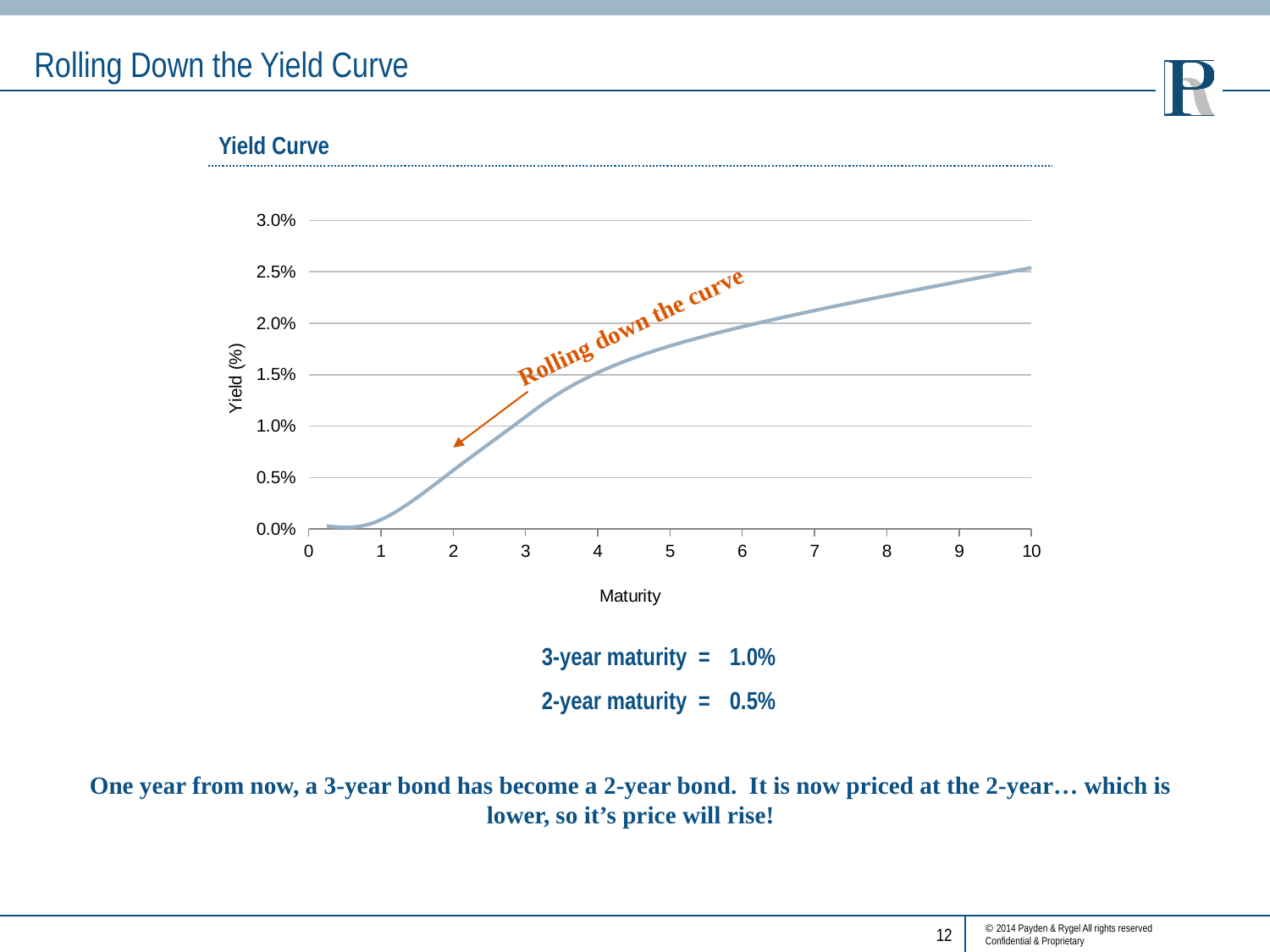
What is the difference between the 3-year maturity yield and the 2-year maturity yield? 0.5% What is the label of the x axis of the chart? Maturity What kind of chart is shown on the slide? line chart According to the slide, what is the yield at a 2-year maturity? 0.5% Does the yield rise or fall as maturity increases along the x axis? rises What is the title of the chart? Yield Curve Is the yield at a maturity of 8 greater or less than 2.0%? greater At which maturity on the chart is the yield highest? 10 Is the yield at a maturity of 5 greater or less than 1.5%? greater According to the slide, what is the yield at a 3-year maturity? 1.0% Is the yield at a maturity of 1 greater or less than 0.5%? less Which has the higher yield, the 3-year maturity or the 2-year maturity? 3-year maturity